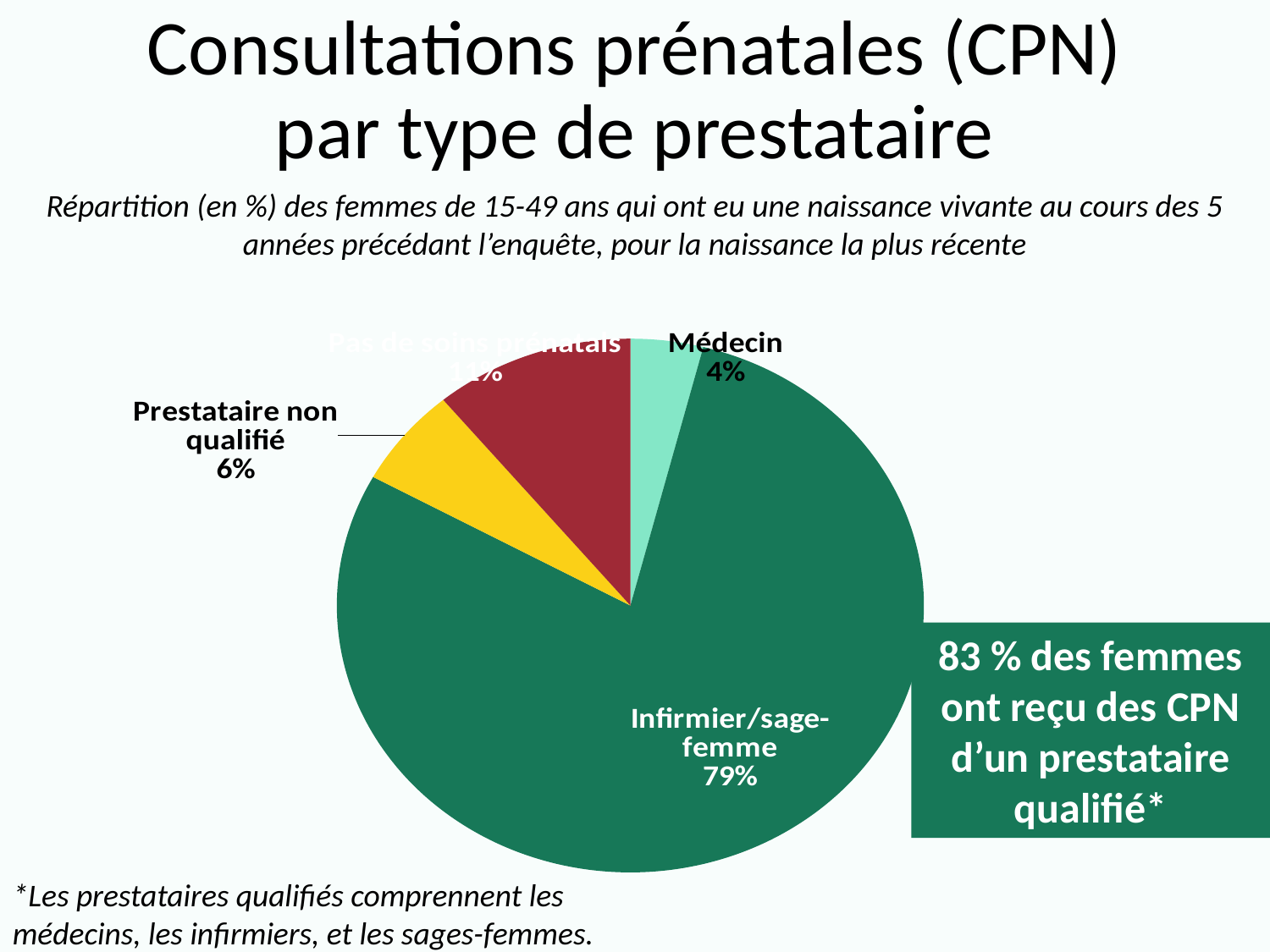
Which slice is larger, Pas de soins prénatals or Prestataire non qualifié? Pas de soins prénatals What is the value shown for the Prestataire non qualifié slice? 6% How many slices does the pie chart have? 4 What is the value shown for the Médecin slice? 4% What is the difference in percentage points between the Prestataire non qualifié slice and the Médecin slice? 2 percentage points What percentage of women received prenatal consultations from an Infirmier/sage-femme? 79% What is the difference in percentage points between the Infirmier/sage-femme slice and the Médecin slice? 75 percentage points According to the green callout box, what percentage of women received CPN from a qualified provider? 83 % What kind of chart is shown on the slide? pie chart Which category has the largest slice of the pie? Infirmier/sage-femme Which slice is larger, Prestataire non qualifié or Médecin? Prestataire non qualifié Which category has the smallest slice of the pie? Médecin